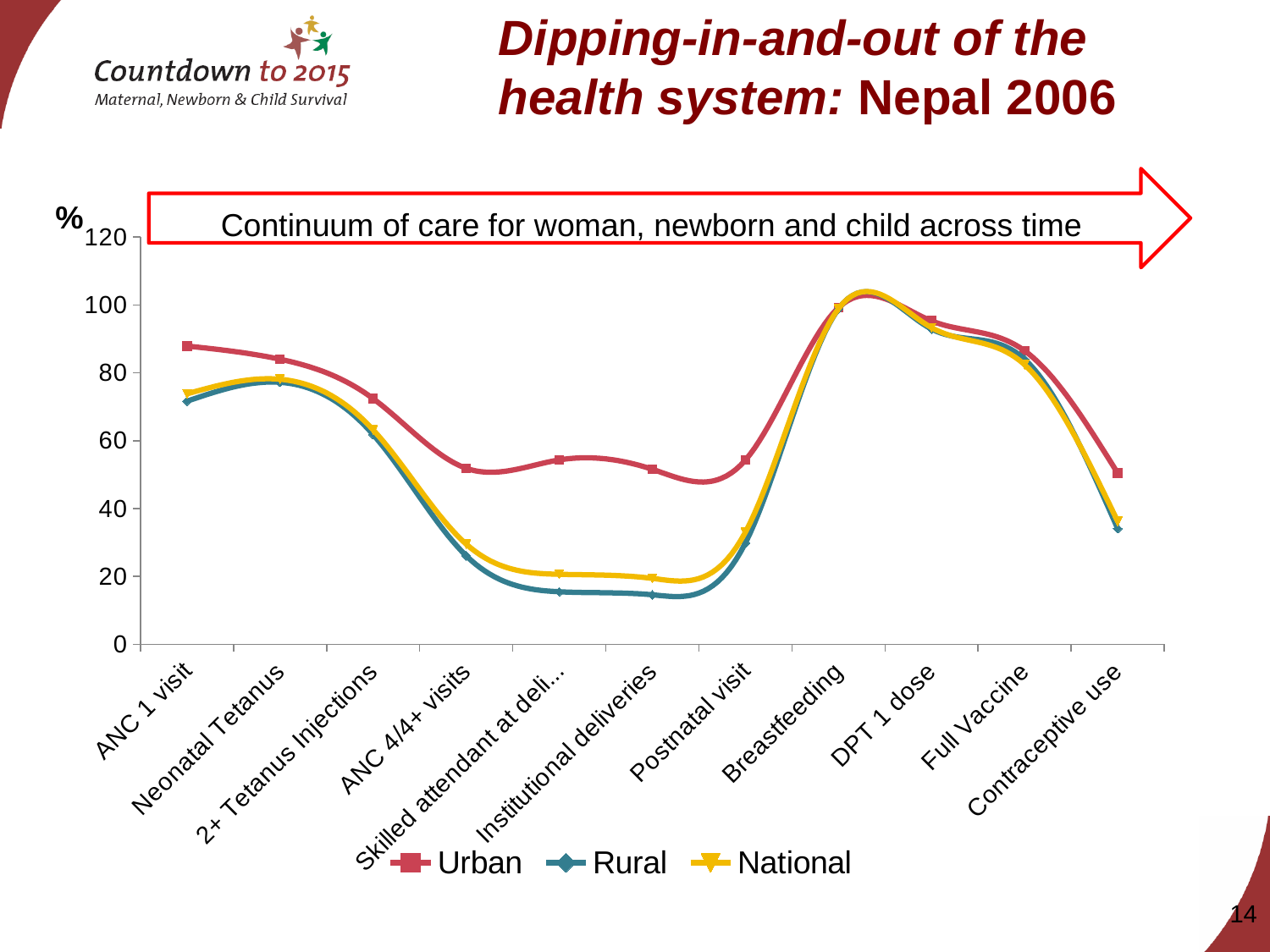
How many categories are shown along the x axis? 11 Is the Urban value for ANC 1 visit greater or less than 80? greater How many series does the legend list? 3 Which category has the highest Urban value? Breastfeeding Which category has the highest Rural value? Breastfeeding Do the Urban values rise or fall from Breastfeeding to Contraceptive use? fall What kind of chart is shown on the slide? line chart Which is larger at Institutional deliveries, the Urban value or the Rural value? Urban Is the Urban value for Contraceptive use greater or less than 60? less What unit is shown on the y axis? % Is the Urban value for Postnatal visit greater or less than 40? greater